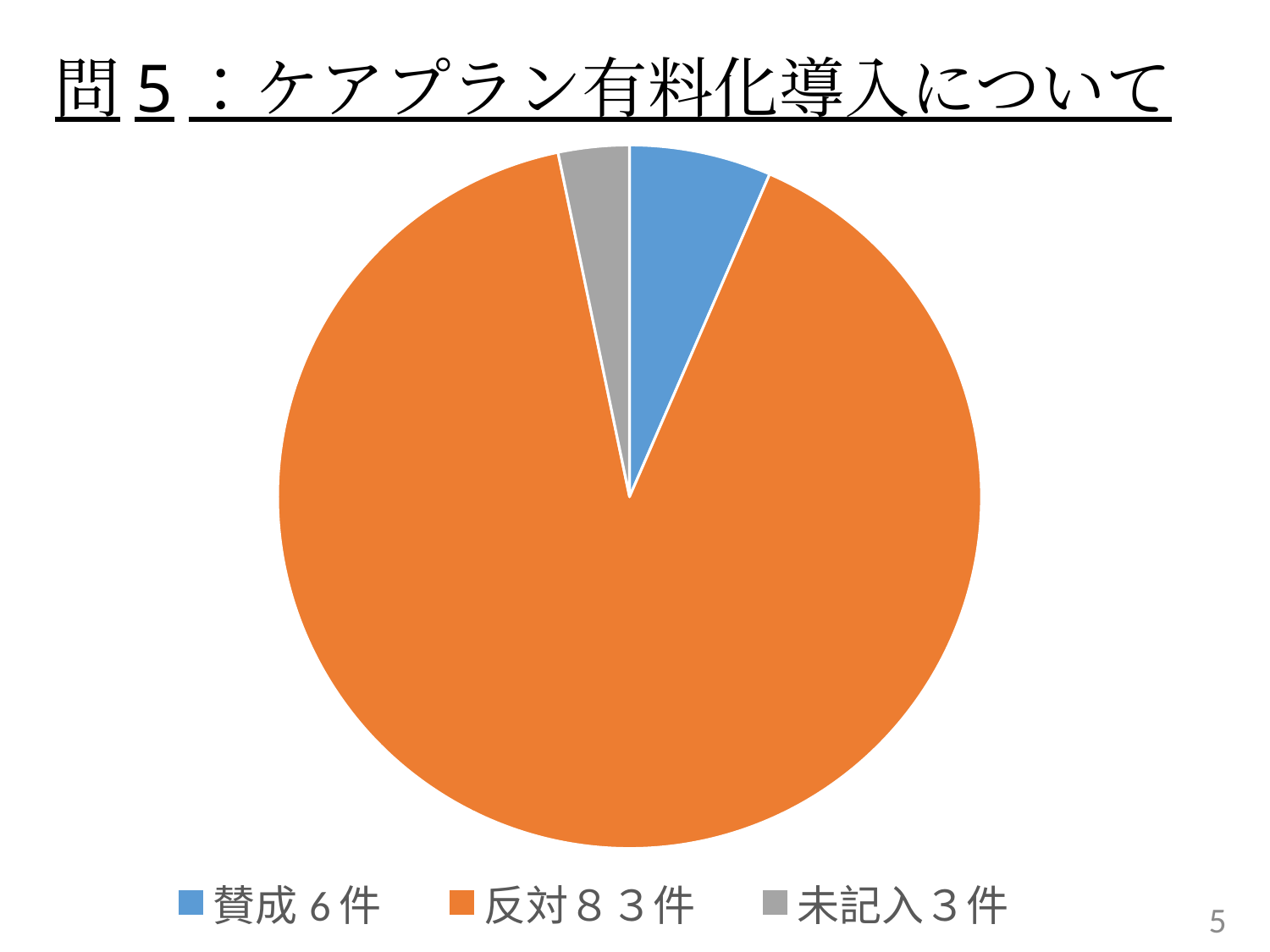
What colour is the slice for 反対? orange How many responses are recorded for 反対 (opposed)? ８３件 Which category has the smallest slice of the pie? 未記入 How many entries does the legend list? 3 How many responses are recorded for 未記入 (not filled in)? ３件 What type of chart is shown on the slide? pie chart Which category has the largest slice of the pie? 反対 How many categories does the pie chart have? 3 What is the difference between the number of 反対 responses and the number of 賛成 responses? 77件 What is the title of the slide containing the pie chart? 問５：ケアプラン有料化導入について How many responses are recorded for 賛成 (in favour)? ６件 Which is larger, the number of 賛成 responses or the number of 未記入 responses? 賛成